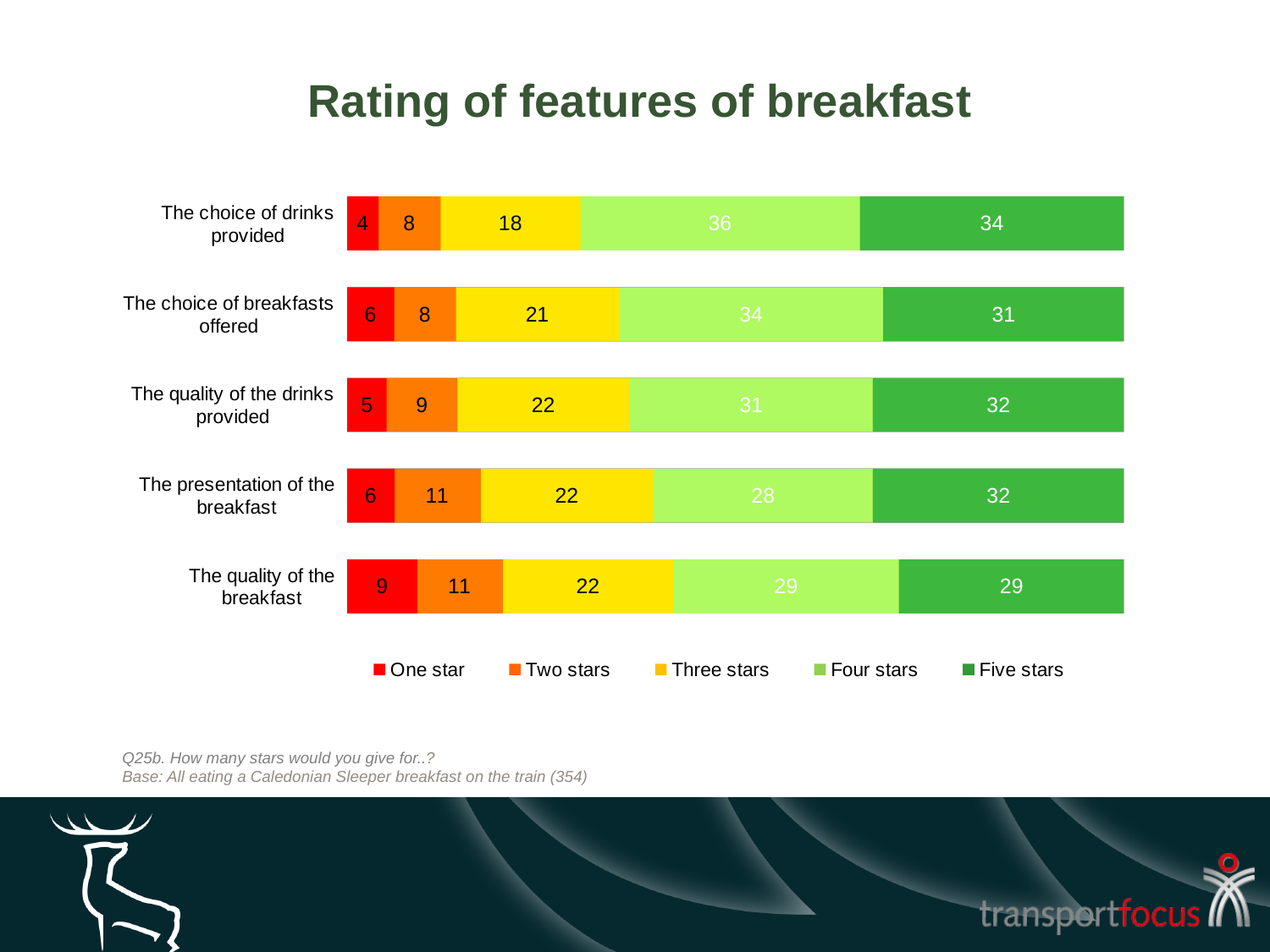
What is the title of the chart? Rating of features of breakfast What is the total of the stacked bar for The quality of the drinks provided? 99 How many categories are shown on the chart? 5 Which category has the lowest One star value? The choice of drinks provided Which is larger: the Three stars value for The choice of breakfasts offered or for The choice of drinks provided? The choice of breakfasts offered What is the One star value for The quality of the breakfast? 9 What is the Five stars value for The choice of drinks provided? 34 What kind of chart is shown on the slide? Stacked bar chart Which category has the highest Four stars value? The choice of drinks provided What is the Two stars value for The presentation of the breakfast? 11 How many series does the legend list? 5 What is the difference between the Four stars values for The choice of drinks provided and The presentation of the breakfast? 8